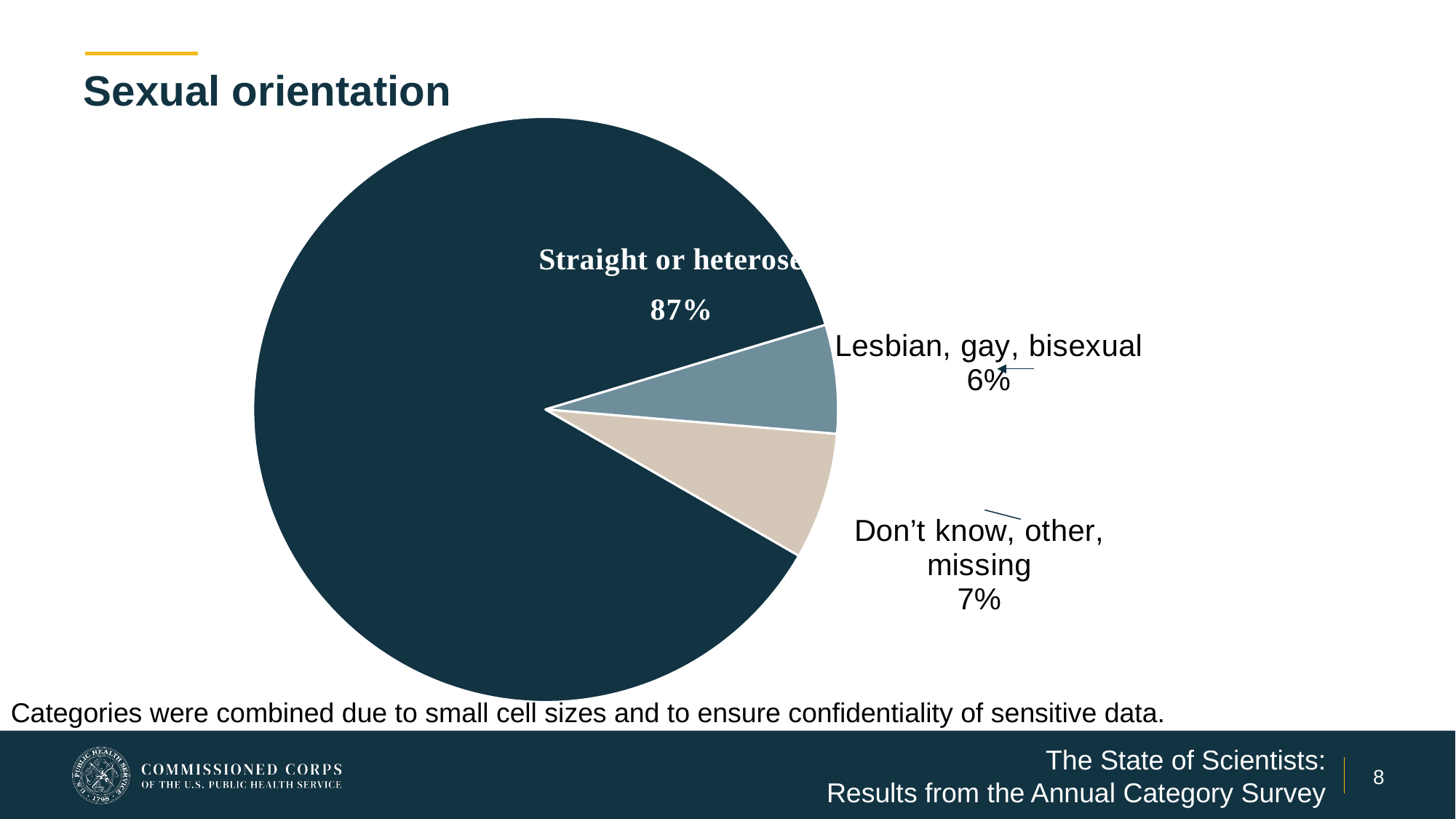
What kind of chart is shown on the slide? Pie chart Which slice is larger: "Don't know, other, missing" or "Lesbian, gay, bisexual"? Don't know, other, missing What is the difference in percentage points between the largest slice (87%) and the "Don't know, other, missing" slice? 80 percentage points What note appears below the pie chart about the categories? Categories were combined due to small cell sizes and to ensure confidentiality of sensitive data. What percentage of the pie is labelled "Lesbian, gay, bisexual"? 6% What percentage of the pie is labelled "Don't know, other, missing"? 7% What is the difference in percentage points between the "Don't know, other, missing" slice and the "Lesbian, gay, bisexual" slice? 1 percentage point How many slices does the pie chart have? 3 Which category has the largest share of the pie chart? Straight or heterosexual Which category has the smallest share of the pie chart? Lesbian, gay, bisexual What percentage is shown for the largest slice of the pie chart? 87% What is the title of the slide containing the pie chart? Sexual orientation